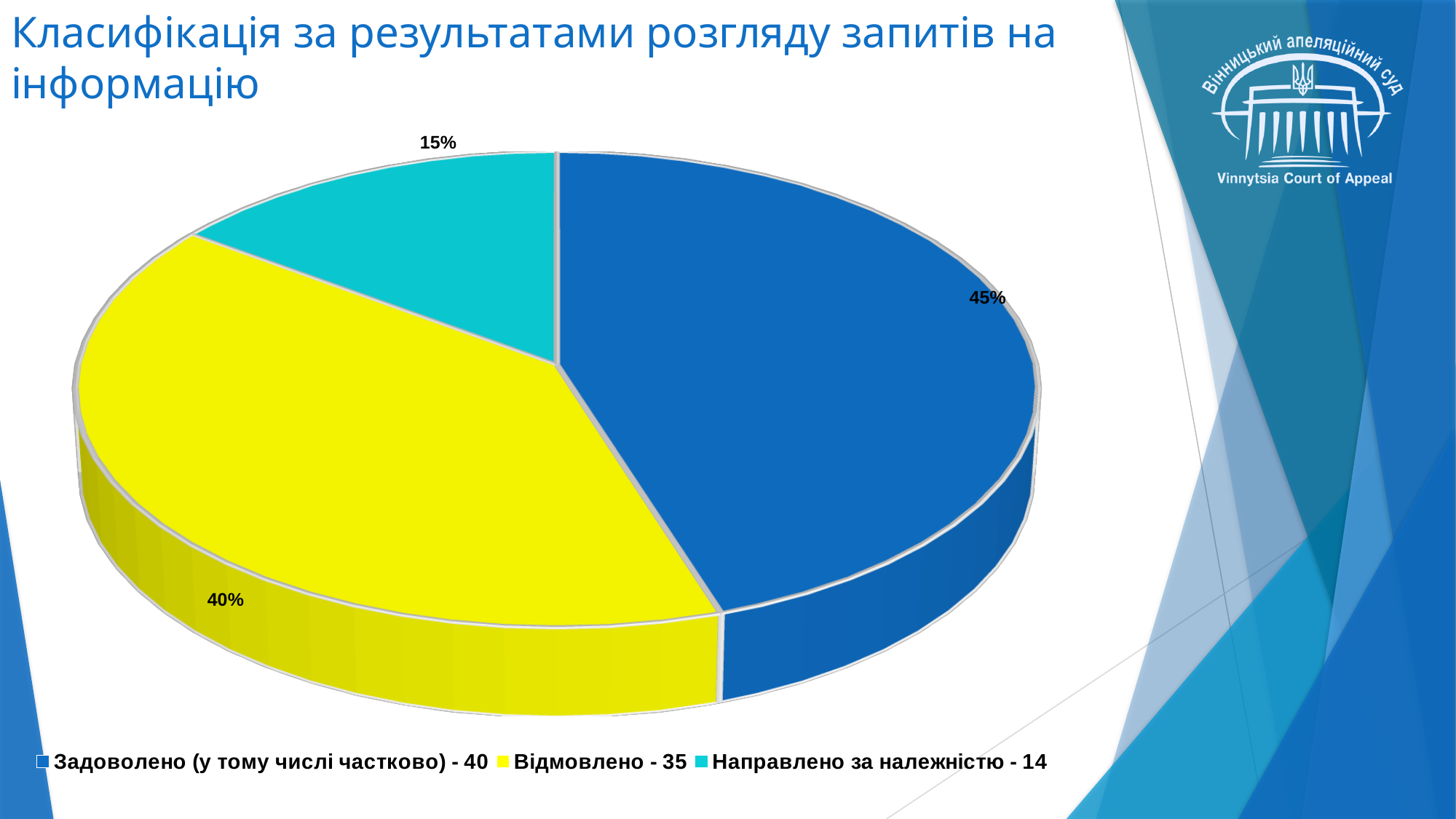
What is the difference in percentage points between the "Відмовлено" slice and the "Направлено за належністю" slice? 25% How many slices does the pie chart have? 3 What percentage share is shown for the slice "Відмовлено - 35"? 40% What percentage share is shown for the slice "Задоволено (у тому числі частково) - 40"? 45% What is the difference in percentage points between the "Задоволено (у тому числі частково)" slice and the "Відмовлено" slice? 5% Which category has the largest share of the pie? Задоволено (у тому числі частково) - 40 What colour is the slice labelled 45%? Blue Which slice is larger: "Відмовлено - 35" or "Направлено за належністю - 14"? Відмовлено - 35 What percentage share is shown for the slice "Направлено за належністю - 14"? 15% What is the title of the chart slide? Класифікація за результатами розгляду запитів на інформацію What kind of chart is shown on the slide? Pie chart Which category has the smallest share of the pie? Направлено за належністю - 14